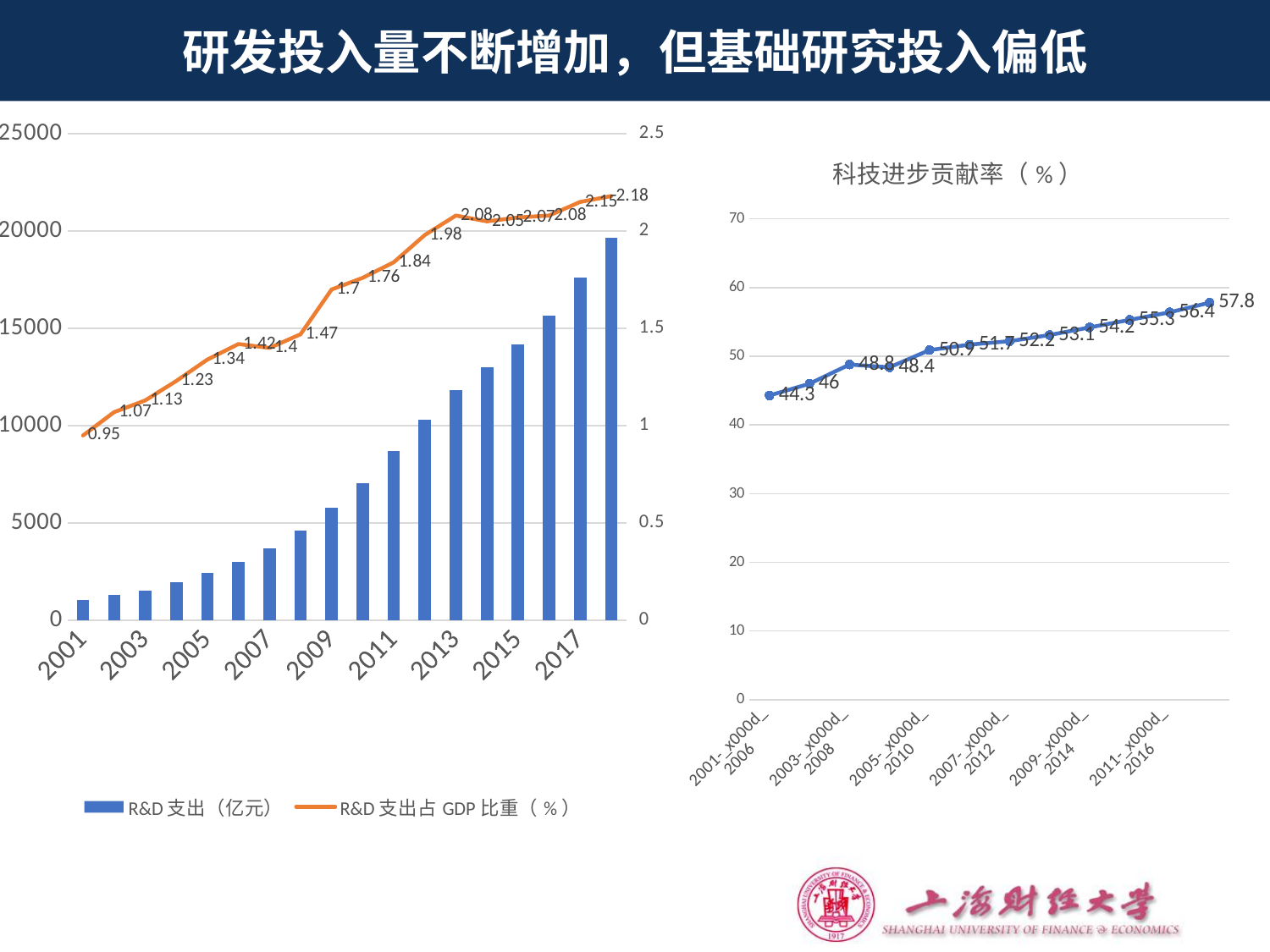
In the left chart, do the R&D 支出（亿元）bars rise or fall from 2001 to 2018? rise In the right chart 科技进步贡献率（%）, what is the highest value shown? 57.8 In the right chart 科技进步贡献率（%）, what is the lowest value shown? 44.3 How many series does the legend of the left chart list? 2 In the left chart, what is the value of R&D 支出占 GDP 比重（%）for 2009? 1.7 In the left chart, what is the highest value shown on the R&D 支出占 GDP 比重（%）line? 2.18 In the left chart, is the R&D 支出（亿元）bar for 2017 greater or less than 15000? greater In the left chart, is the R&D 支出（亿元）bar for 2013 greater or less than 10000? greater What is the title of the chart on the right? 科技进步贡献率（%） In the left chart, what is the value of R&D 支出占 GDP 比重（%）for 2001? 0.95 What kind of chart is the right chart 科技进步贡献率（%）? line chart In the left chart, what is the difference between the R&D 支出占 GDP 比重（%）values for 2018 and 2001? 1.23